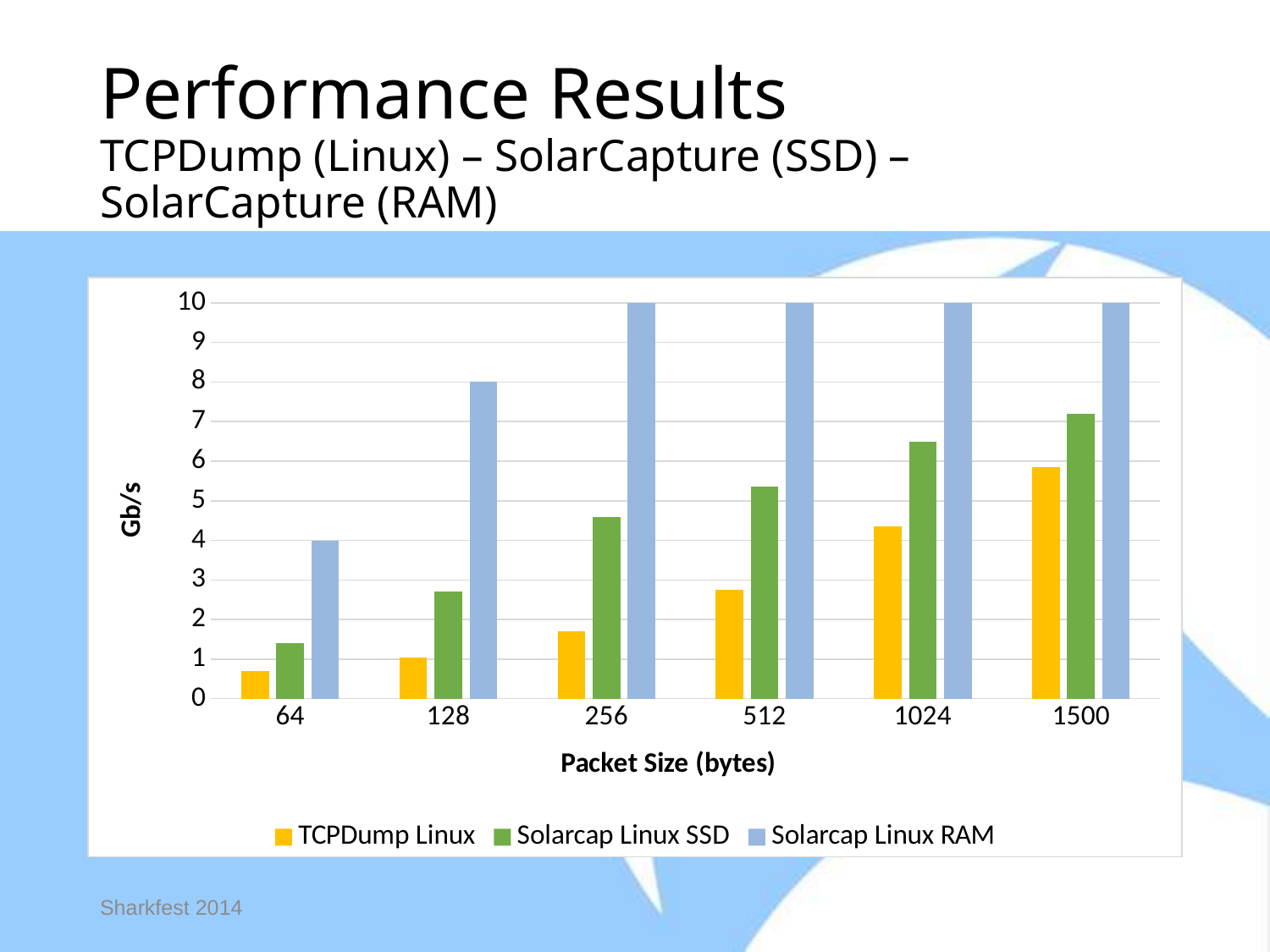
Which is larger: Solarcap Linux SSD at packet size 512 or TCPDump Linux at packet size 512? Solarcap Linux SSD at packet size 512 Do the TCPDump Linux values rise or fall as packet size increases along the x axis? rise How many packet size categories are shown on the x axis? 6 What is the value for Solarcap Linux RAM at packet size 128? 8 Is the value for Solarcap Linux SSD at packet size 64 greater or less than 2? less What is the value for Solarcap Linux RAM at packet size 64? 4 Which series has the highest value at packet size 256? Solarcap Linux RAM Which series has the lowest value at packet size 1024? TCPDump Linux How many series does the legend list? 3 What is the value for Solarcap Linux RAM at packet size 1500? 10 What type of chart is shown on the slide? bar chart Is the value for TCPDump Linux at packet size 1500 greater or less than 5? greater